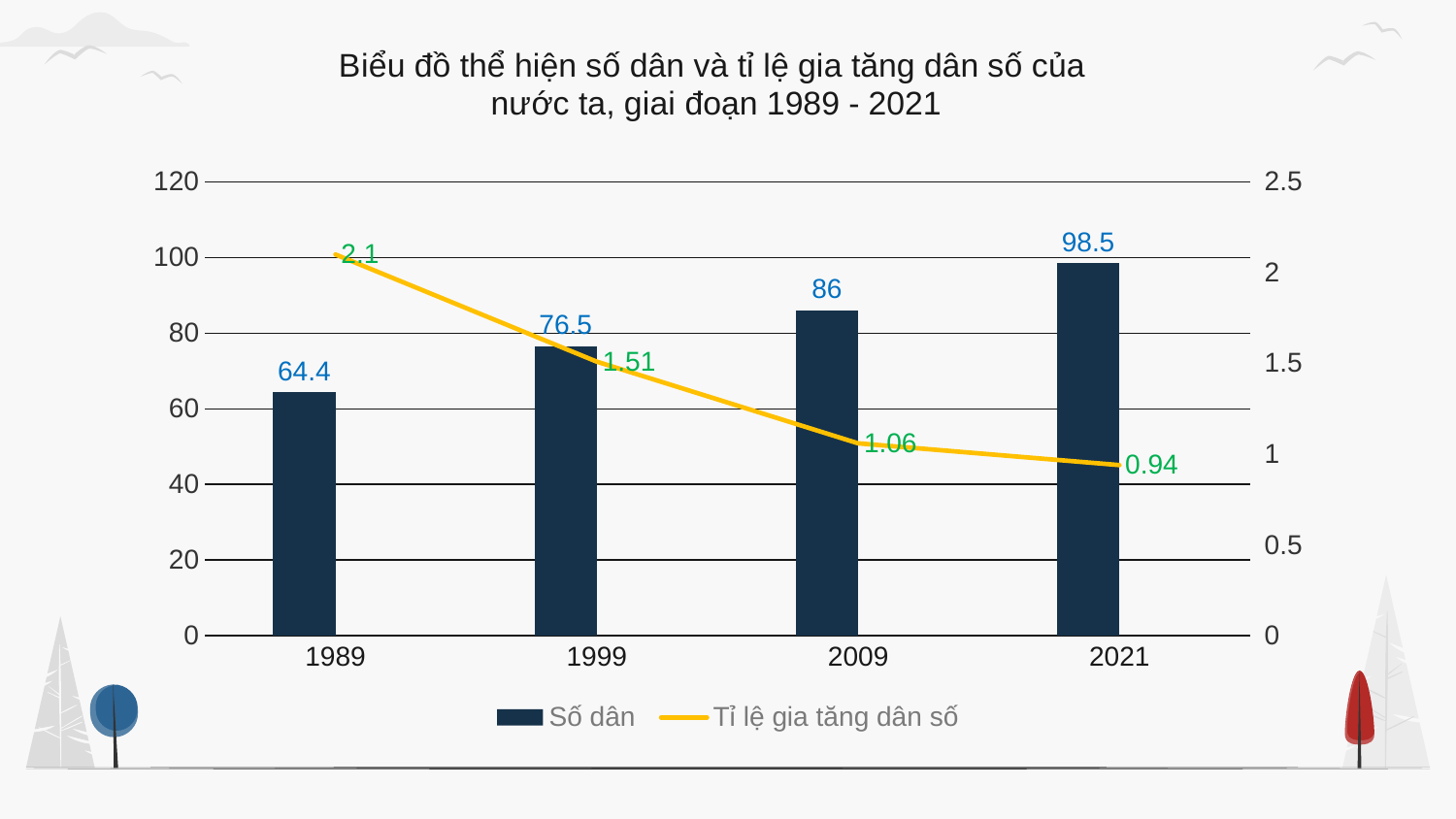
What is the value of Số dân for 1989? 64.4 Does the Tỉ lệ gia tăng dân số line rise or fall from 1989 to 2021? fall How many series does the legend list? 2 What is the value of Số dân for 2021? 98.5 Which year has the highest value for Số dân? 2021 Which series is drawn as a line? Tỉ lệ gia tăng dân số Which is larger, the Số dân value for 1999 or for 2009? 2009 How many years are shown on the x axis? 4 What is the value of Tỉ lệ gia tăng dân số for 1999? 1.51 Which year has the lowest value for Tỉ lệ gia tăng dân số? 2021 What is the difference between the Số dân values for 2021 and 1989? 34.1 What is the value of Tỉ lệ gia tăng dân số for 2009? 1.06